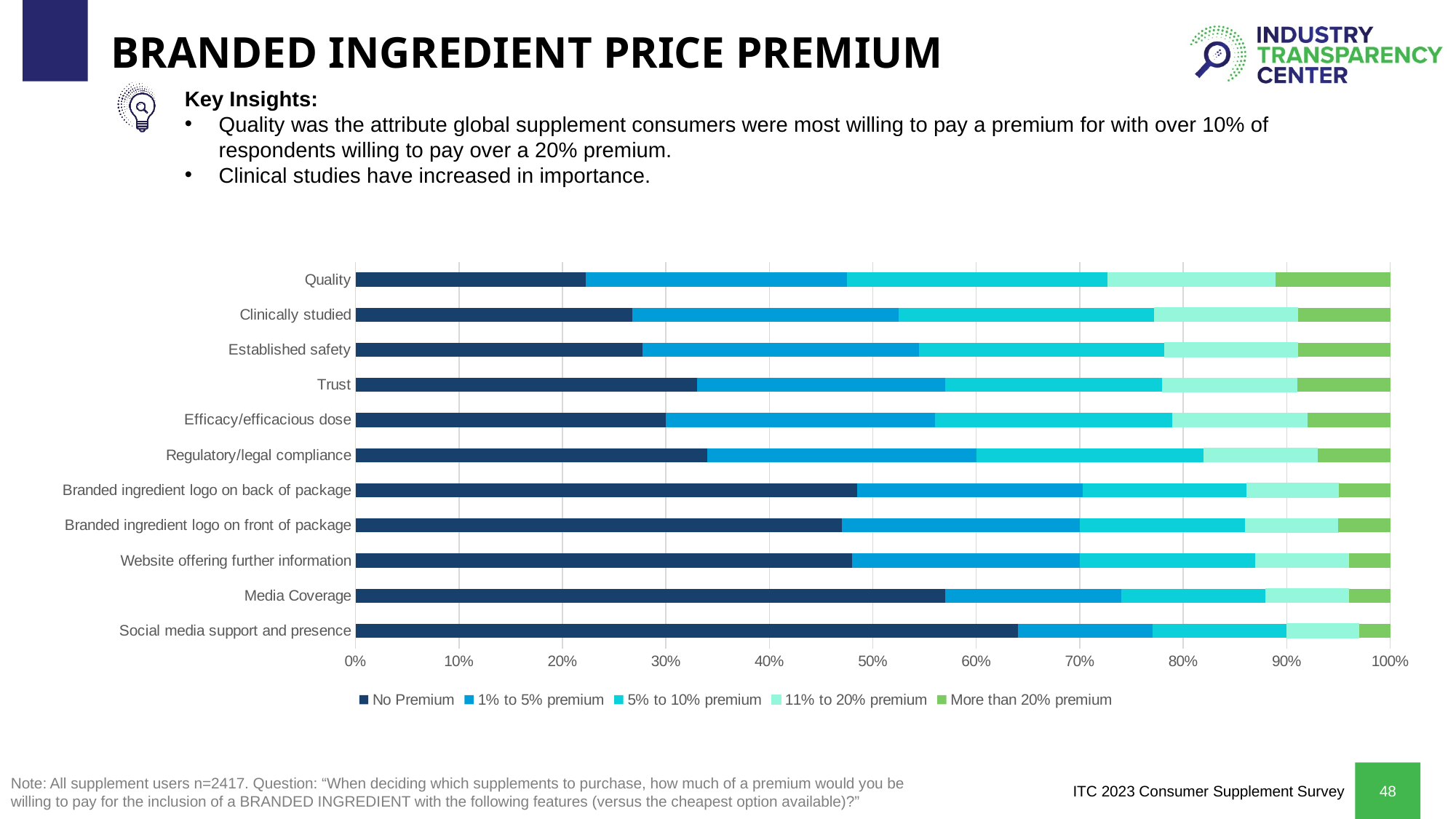
How many categories (attributes) are plotted on the chart? 11 Which category has the smallest 'No Premium' segment? Quality Is the 'No Premium' value for Quality greater or less than 30%? less Which category has the largest 'No Premium' segment? Social media support and presence Is the 'No Premium' value for Social media support and presence greater or less than 60%? greater Which category has the largest 'More than 20% premium' segment? Quality What is the first entry in the chart legend? No Premium How many series does the chart legend list? 5 What kind of chart is shown on the slide? Stacked bar chart Is the 'No Premium' value for Media Coverage greater or less than 50%? greater Moving down the chart from Quality to Social media support and presence, does the 'No Premium' segment generally increase or decrease? Increase Which has a larger 'No Premium' share: Trust or Social media support and presence? Social media support and presence